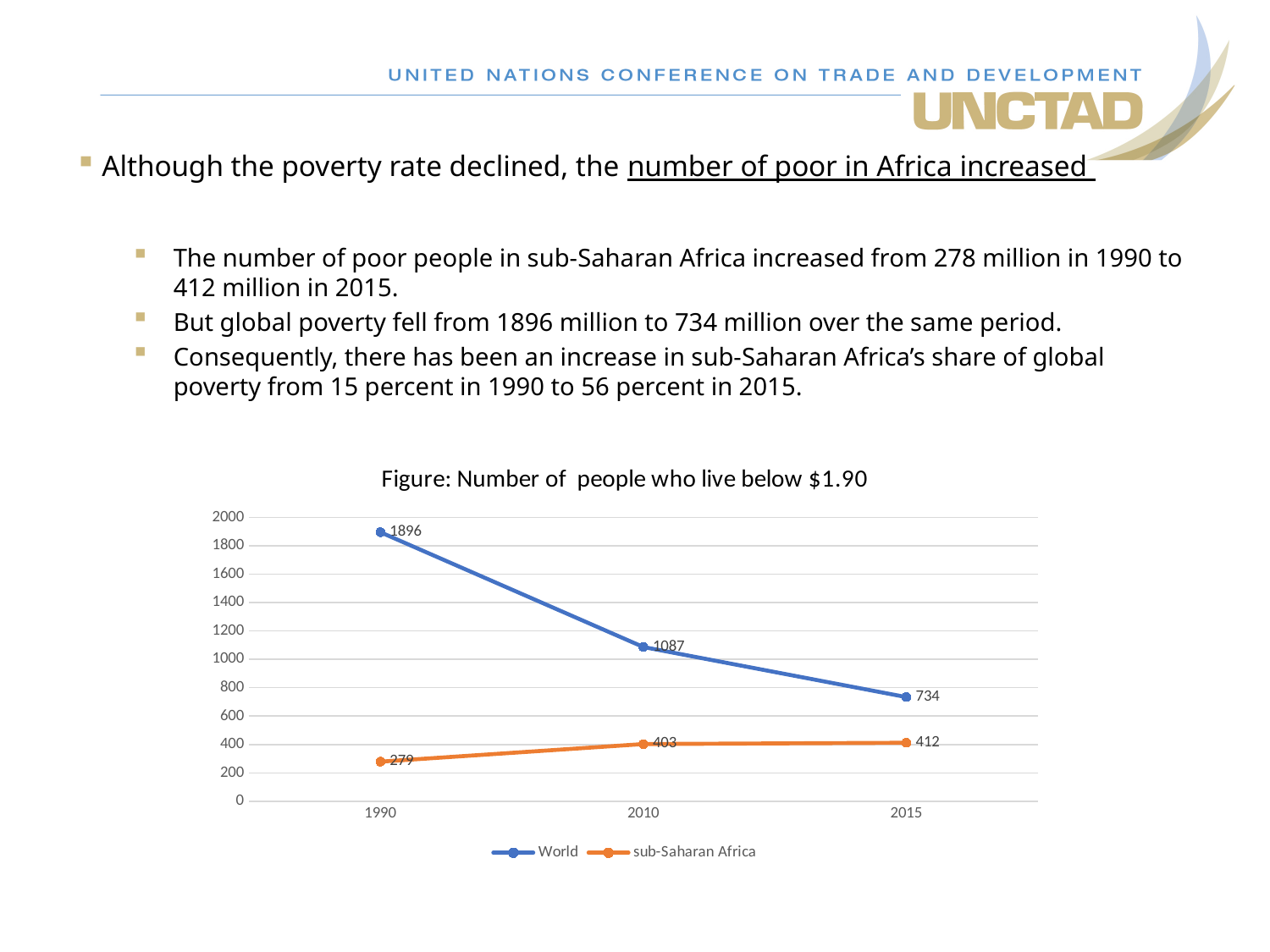
What type of chart is shown on the slide? line chart What is the difference between the World value in 1990 and the World value in 2015? 1162 What is the value for World in 1990? 1896 How many series does the legend list? 2 What is the value for World in 2010? 1087 Which is larger in 2010, the World value or the sub-Saharan Africa value? World How many years are plotted on the x axis? 3 What is the title of the chart? Figure: Number of people who live below $1.90 In which year is the World series at its lowest? 2015 Does the World series rise or fall from 1990 to 2015? fall What is the value for sub-Saharan Africa in 2015? 412 In which year is the sub-Saharan Africa series at its highest? 2015